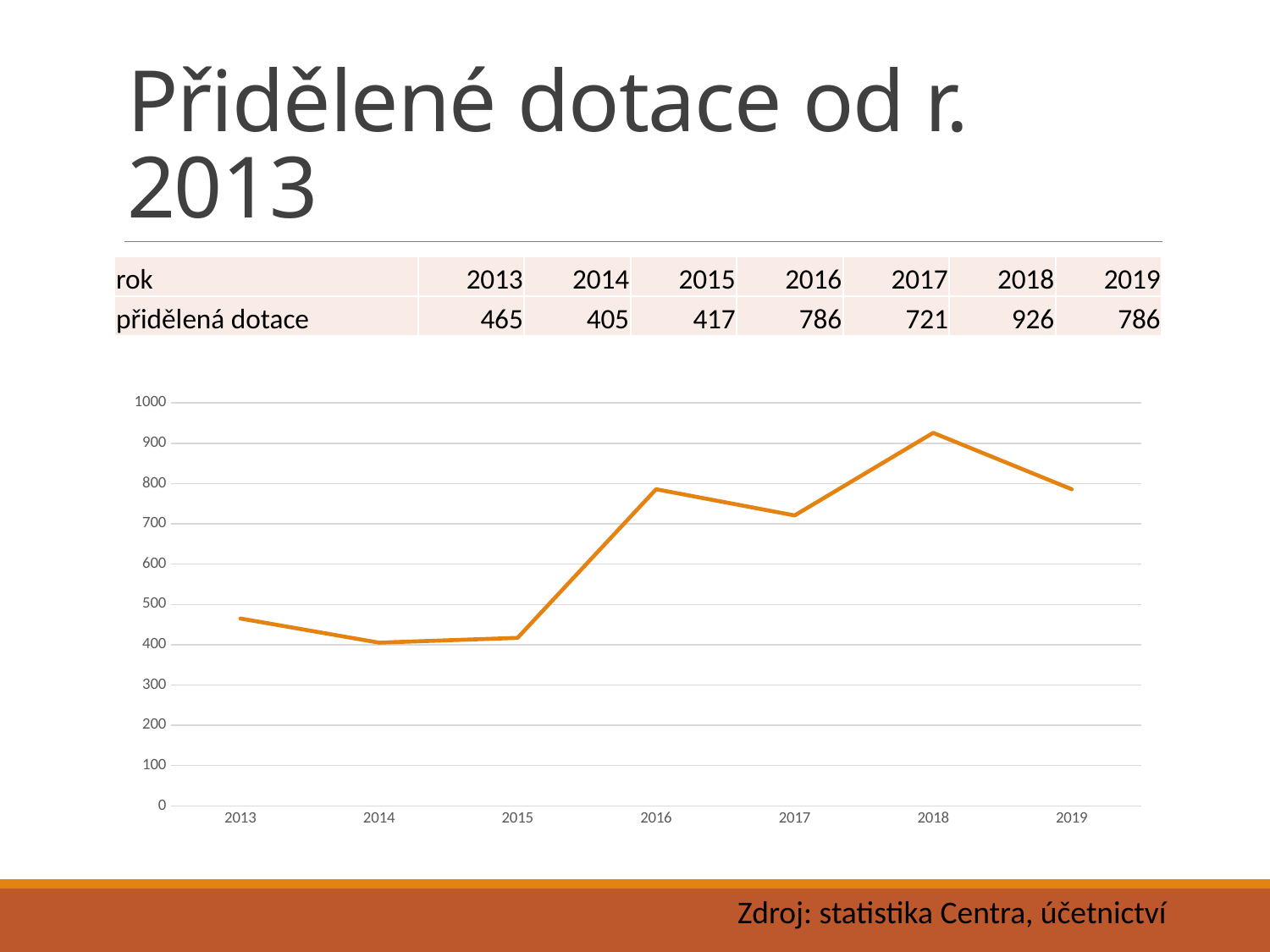
Which year had a larger allocated subsidy, 2013 or 2015? 2013 Which year had the highest allocated subsidy? 2018 What is the difference between the allocated subsidy in 2018 and in 2017? 205 What was the allocated subsidy in 2014? 405 What is the title of the slide containing the chart? Přidělené dotace od r. 2013 What type of chart is shown on the slide? line chart What was the allocated subsidy (přidělená dotace) in 2016? 786 Did the allocated subsidy rise or fall from 2015 to 2016? rise What is the difference between the allocated subsidy in 2013 and in 2014? 60 Which year had the lowest allocated subsidy? 2014 How many years are plotted on the x axis of the chart? 7 Is the value for 2017 greater or less than 600? greater